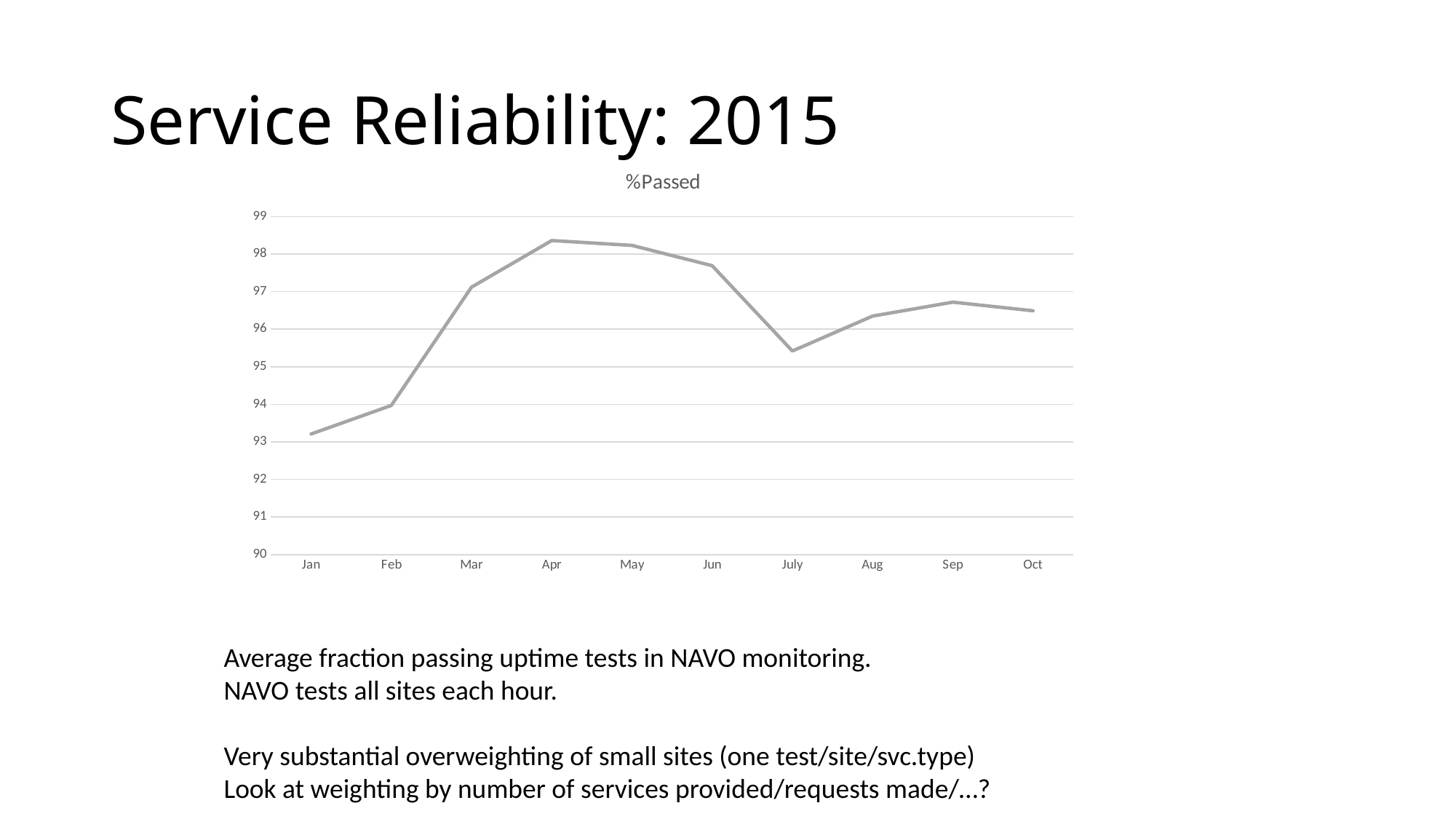
What kind of chart is shown on the slide? line chart What is the title of the chart? %Passed Which is larger, the value for Feb or the value for Mar? Mar Which month has the lowest %Passed value? Jan How many months are plotted on the x axis? 10 Do the values rise or fall from Jan to Apr? rise Is the value for Jan greater or less than 94? less Is the value for Apr greater or less than 98? greater Which month has the highest %Passed value? Apr Is the value for July greater or less than 96? less Which is larger, the value for Jun or the value for July? Jun